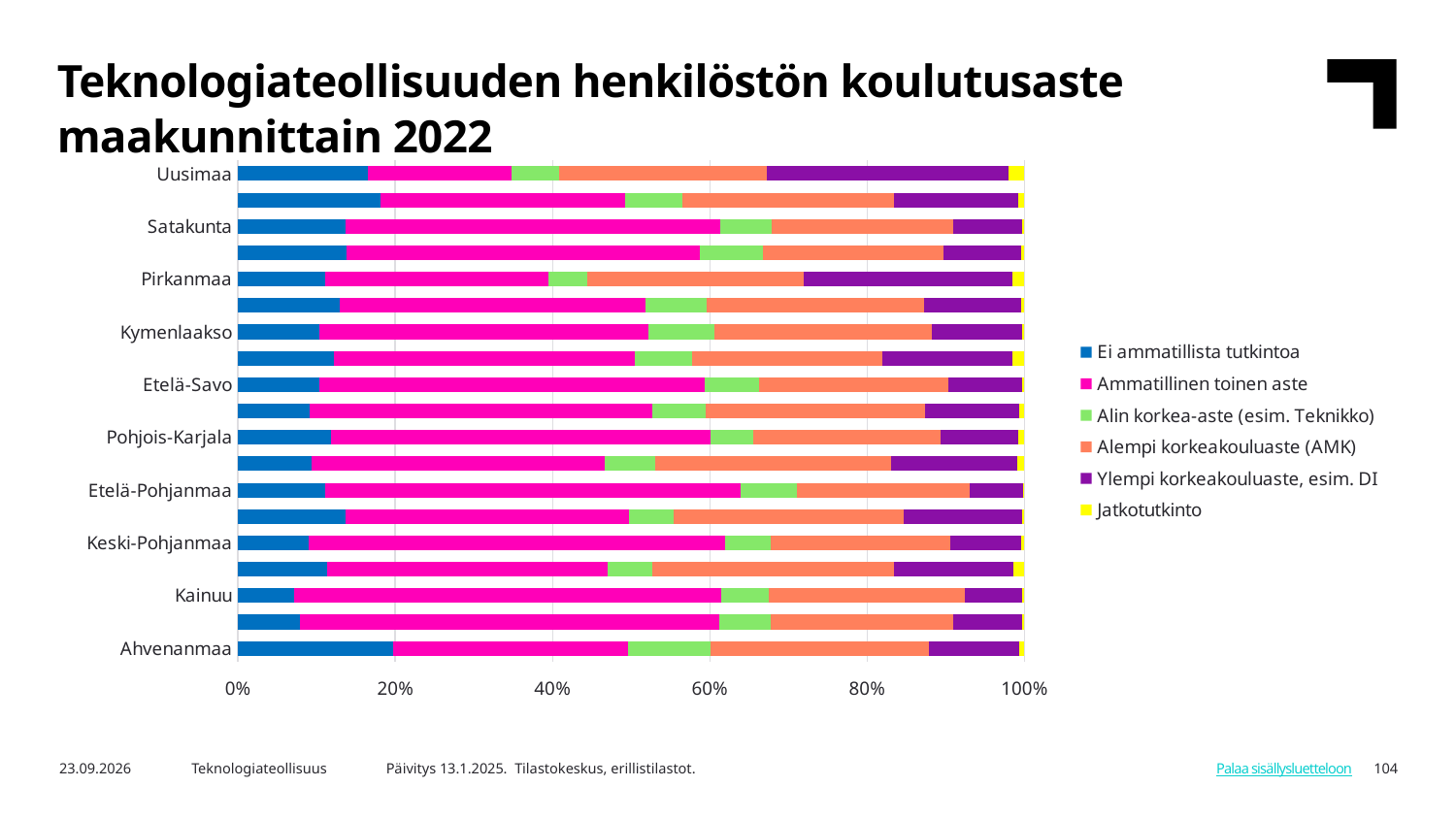
Which has a larger share of 'Ylempi korkeakouluaste, esim. DI', Uusimaa or Kainuu? Uusimaa Which colour represents the series 'Jatkotutkinto' in the legend? Yellow Which has a larger share of 'Ei ammatillista tutkintoa', Uusimaa or Kainuu? Uusimaa Is the value for 'Ylempi korkeakouluaste, esim. DI' in Uusimaa greater or less than 20%? greater Which has a larger share of 'Ammatillinen toinen aste', Pirkanmaa or Kainuu? Kainuu Is the value for 'Ei ammatillista tutkintoa' in Uusimaa greater or less than 20%? less Is the value for 'Ei ammatillista tutkintoa' in Kainuu greater or less than 20%? less What kind of chart is shown on the slide? Stacked bar chart How many series does the legend list? 6 What is the title of the chart? Teknologiateollisuuden henkilöstön koulutusaste maakunnittain 2022